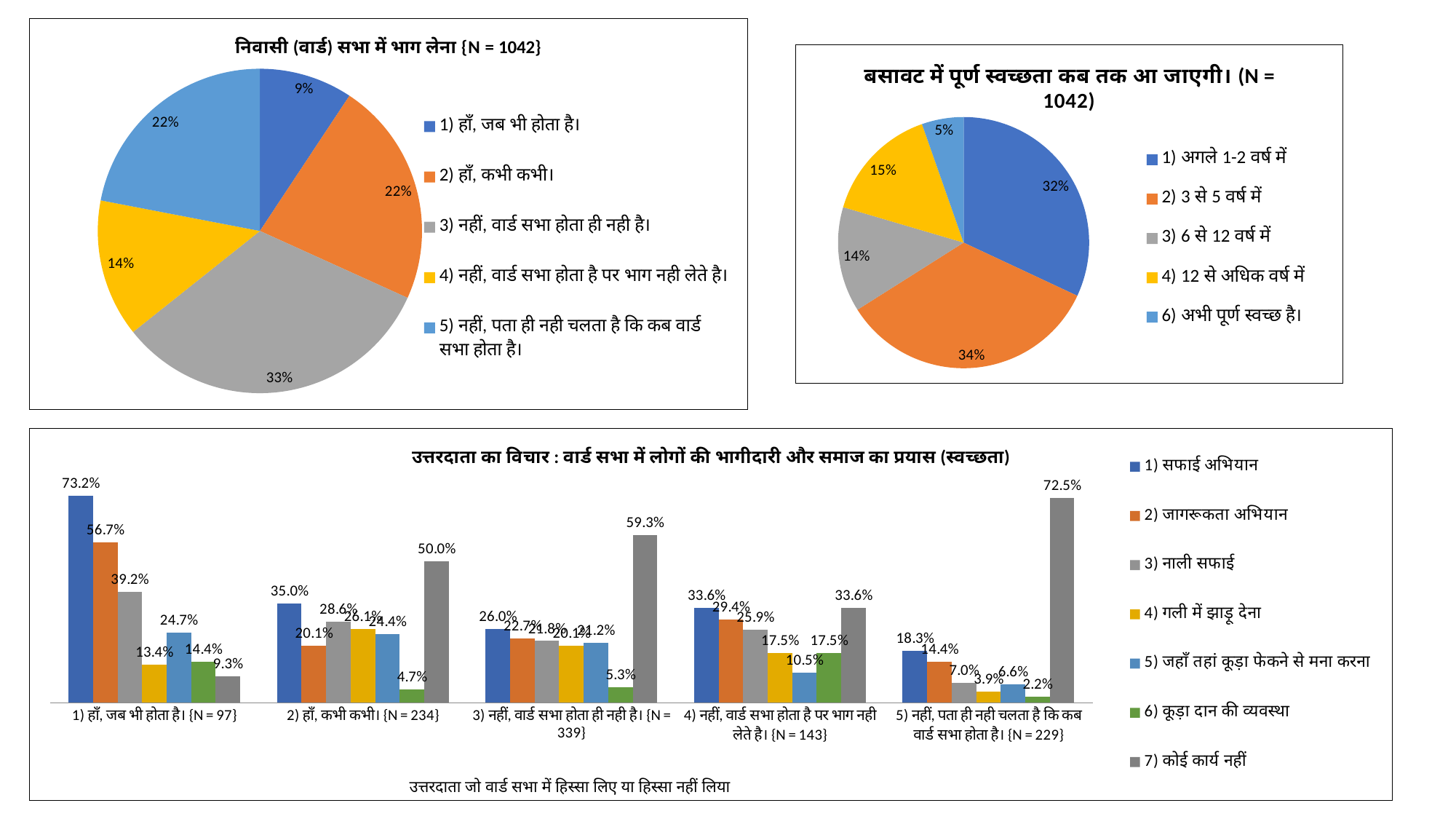
In the top-left pie chart (निवासी (वार्ड) सभा में भाग लेना), how many slices does the pie have? 5 In the bottom bar chart, what is the value of '1) सफाई अभियान' for the category '1) हाँ, जब भी होता है। {N = 97}'? 73.2% In the top-right pie chart (बसावट में पूर्ण स्वच्छता कब तक आ जाएगी), what share does '2) 3 से 5 वर्ष में' have? 34% In the bottom bar chart, what is the value of '7) कोई कार्य नहीं' for the category '5) नहीं, पता ही नही चलता है कि कब वार्ड सभा होता है। {N = 229}'? 72.5% What kind of chart is the bottom chart (उत्तरदाता का विचार : वार्ड सभा में लोगों की भागीदारी और समाज का प्रयास)? bar chart In the top-left pie chart (निवासी (वार्ड) सभा में भाग लेना), what share does the slice for '3) नहीं, वार्ड सभा होता ही नही है।' have? 33% In the bottom bar chart, what is the difference between '1) सफाई अभियान' and '2) जागरूकता अभियान' for the category '1) हाँ, जब भी होता है। {N = 97}'? 16.5% In the bottom bar chart, which is larger for the category '3) नहीं, वार्ड सभा होता ही नही है। {N = 339}': '1) सफाई अभियान' or '7) कोई कार्य नहीं'? 7) कोई कार्य नहीं In the bottom bar chart, how many series does the legend list? 7 In the top-right pie chart (बसावट में पूर्ण स्वच्छता कब तक आ जाएगी), what is the difference between the shares for '1) अगले 1-2 वर्ष में' and '6) अभी पूर्ण स्वच्छ है।'? 27% In the top-left pie chart (निवासी (वार्ड) सभा में भाग लेना), which category has the smallest slice? 1) हाँ, जब भी होता है। In the top-right pie chart (बसावट में पूर्ण स्वच्छता कब तक आ जाएगी), which category has the largest slice? 2) 3 से 5 वर्ष में